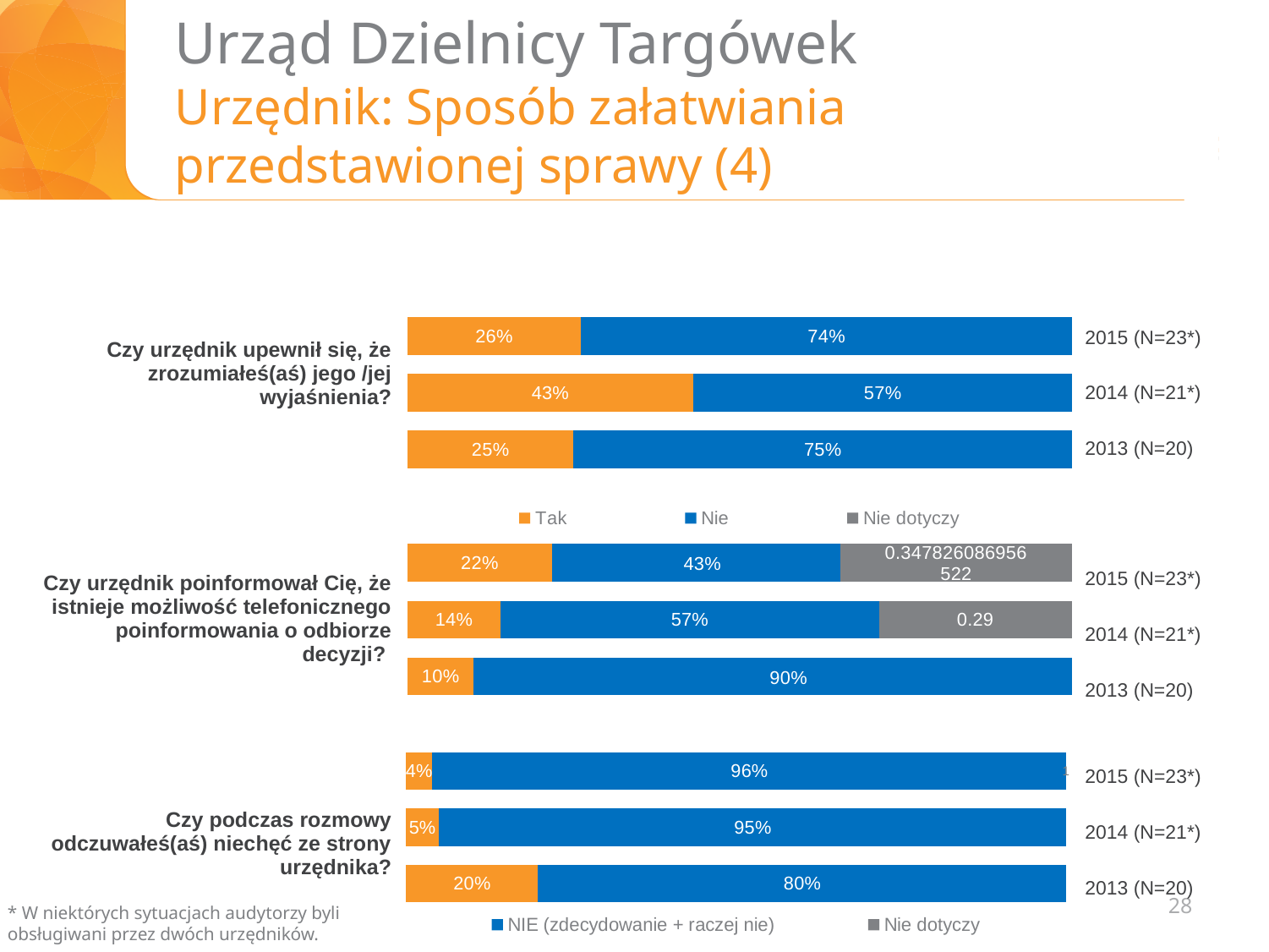
In the middle chart ("Czy urzędnik poinformował Cię, że istnieje możliwość telefonicznego poinformowania o odbiorze decyzji?"), what is the "Tak" value for 2014 (N=21*)? 14% In the middle chart ("Czy urzędnik poinformował Cię, że istnieje możliwość telefonicznego poinformowania o odbiorze decyzji?"), which year has the lowest "Tak" share? 2013 (N=20) In the bottom chart ("Czy podczas rozmowy odczuwałeś(aś) niechęć ze strony urzędnika?"), what is the "NIE (zdecydowanie + raczej nie)" value for 2015 (N=23*)? 96% What type of chart is used on this slide? Stacked bar chart In the bottom chart ("Czy podczas rozmowy odczuwałeś(aś) niechęć ze strony urzędnika?"), which year has the highest orange ("Tak") share? 2013 (N=20) In the top chart ("Czy urzędnik upewnił się, że zrozumiałeś(aś) jego /jej wyjaśnienia?"), what is the "Nie" value for 2014 (N=21*)? 57% In the bottom chart ("Czy podczas rozmowy odczuwałeś(aś) niechęć ze strony urzędnika?"), is the "NIE" value for 2014 (N=21*) larger or smaller than for 2013 (N=20)? larger In the middle chart ("Czy urzędnik poinformował Cię, że istnieje możliwość telefonicznego poinformowania o odbiorze decyzji?"), what is the "Nie" value for 2013 (N=20)? 90% In the top chart ("Czy urzędnik upewnił się, że zrozumiałeś(aś) jego /jej wyjaśnienia?"), which year has the highest "Tak" share? 2014 (N=21*) In the top chart ("Czy urzędnik upewnił się, że zrozumiałeś(aś) jego /jej wyjaśnienia?"), what is the "Tak" value for 2015 (N=23*)? 26% In the top chart ("Czy urzędnik upewnił się, że zrozumiałeś(aś) jego /jej wyjaśnienia?"), what is the difference between the "Nie" values for 2013 (N=20) and 2014 (N=21*)? 18 percentage points How many series does the legend of the middle chart list? 3